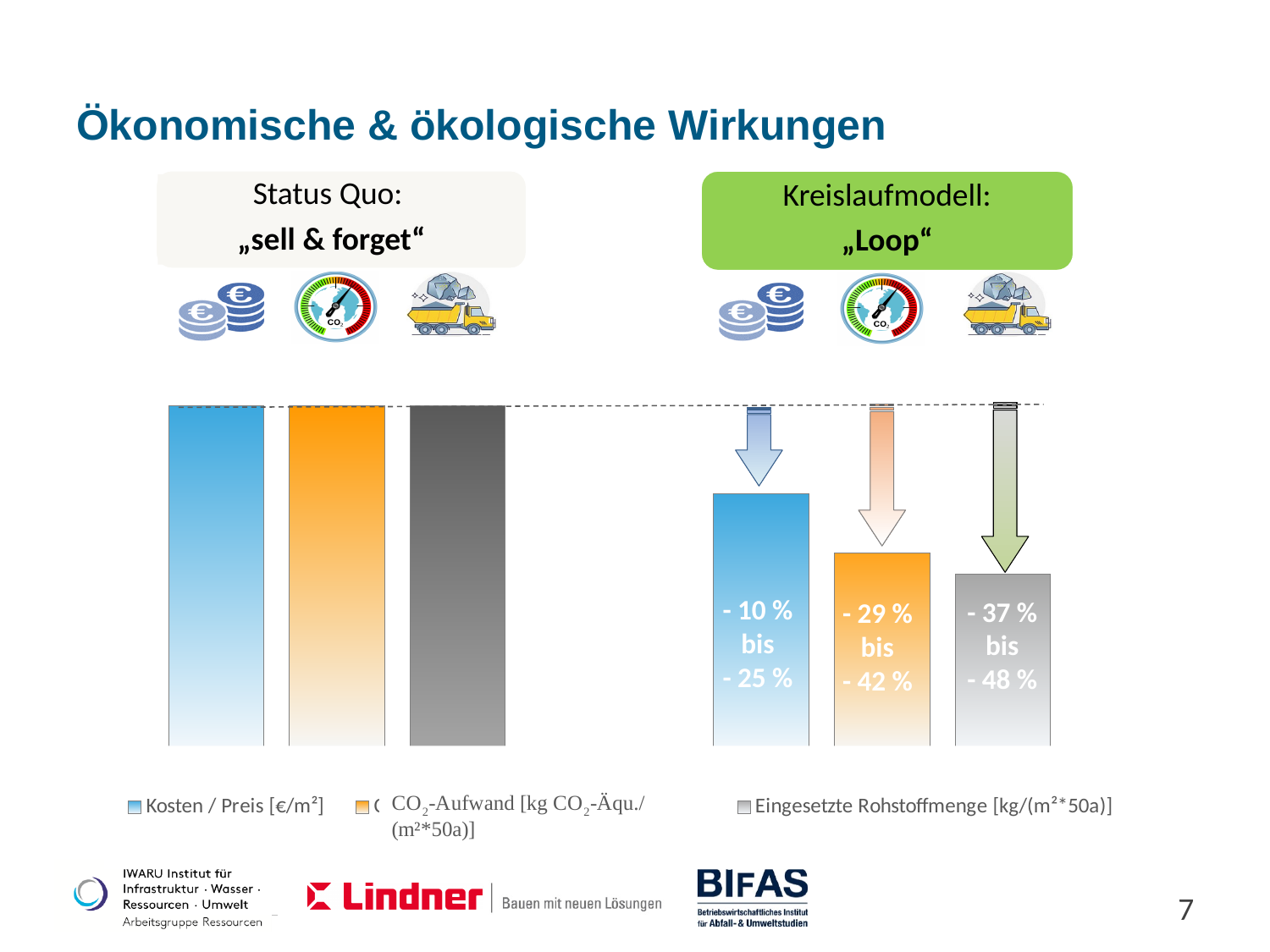
Among the three "Loop" bars, which series has the tallest bar? Kosten / Preis [€/m²] What colour is the Kosten / Preis [€/m²] series in the legend? blue How many series does the legend list? 3 Is the Kosten / Preis bar taller for "sell & forget" or for "Loop"? sell & forget What kind of chart is shown on the slide? bar chart How many scenario groups of bars are shown in the chart? 2 Which series shows the largest reduction range in the "Loop" model? Eingesetzte Rohstoffmenge [kg/(m²*50a)] What is the title of the slide containing the chart? Ökonomische & ökologische Wirkungen What reduction range is printed on the CO2-Aufwand bar for the "Loop" model? - 29 % bis - 42 % What reduction range is printed on the Kosten / Preis bar for the "Loop" model? - 10 % bis - 25 % What reduction range is printed on the Eingesetzte Rohstoffmenge bar for the "Loop" model? - 37 % bis - 48 % Among the three "Loop" bars, which series has the shortest bar? Eingesetzte Rohstoffmenge [kg/(m²*50a)]